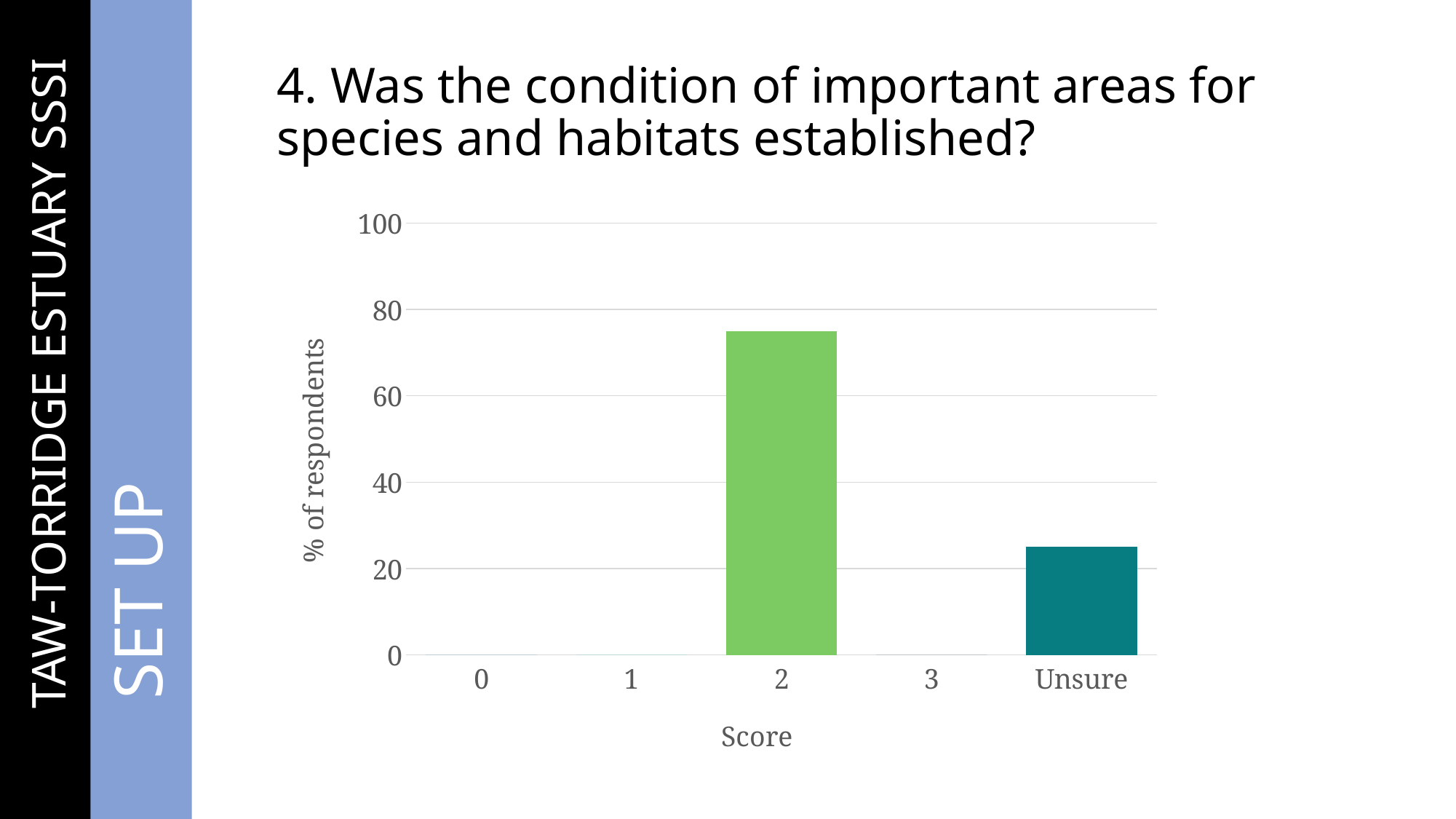
Is the value for Unsure greater or less than 40? less Which score category has the highest percentage of respondents? 2 What is the label of the horizontal axis? Score What is the value for score 3? 0 What kind of chart is shown on the slide? bar chart How many categories are shown on the x axis of the chart? 5 Is the value for Unsure greater or less than 20? greater Is the value for score 2 greater or less than 80? less How many categories have a visible bar in the chart? 2 What is the label of the vertical axis? % of respondents Which has a larger percentage of respondents, score 2 or Unsure? 2